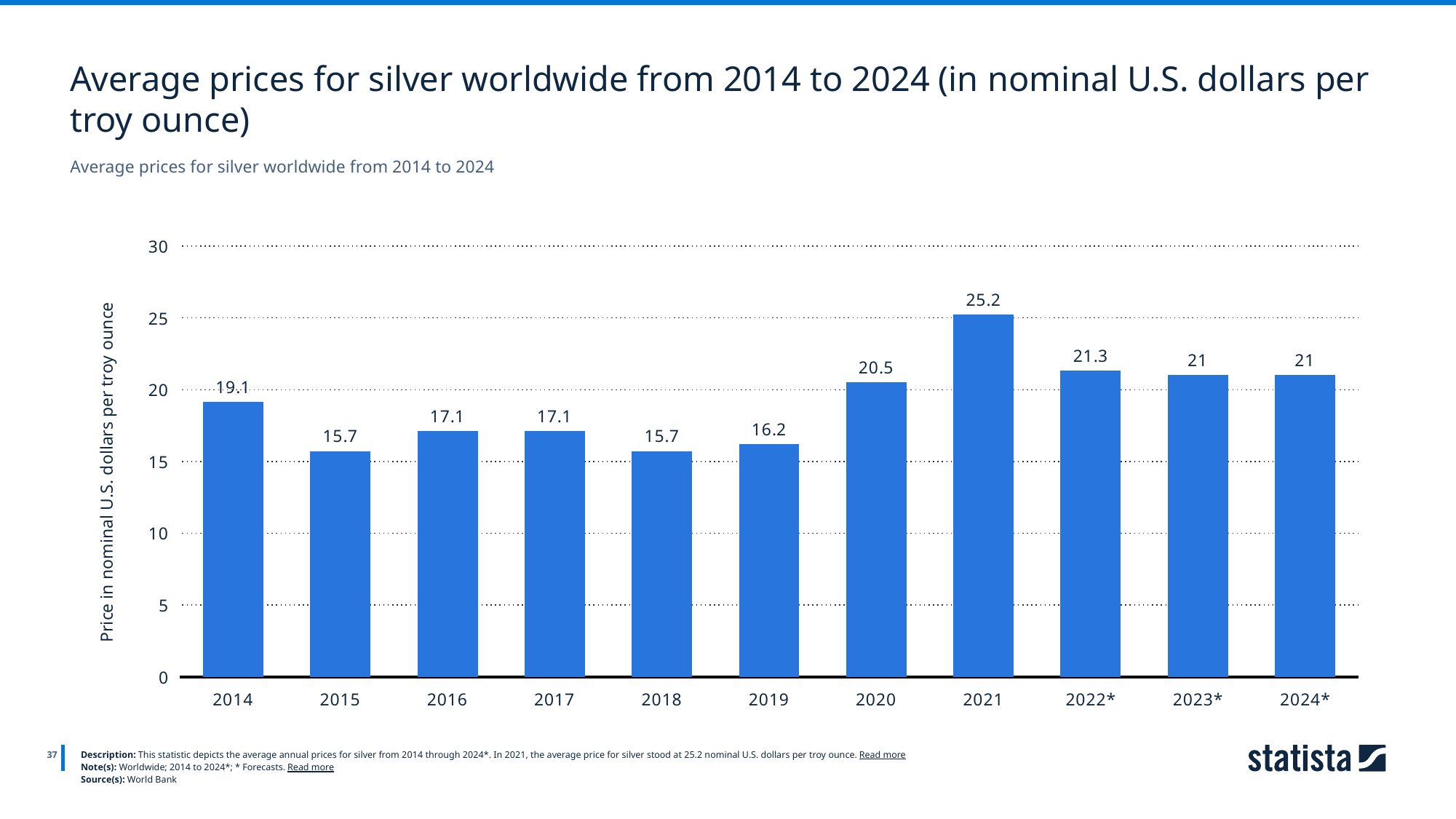
What is the forecast average silver price for 2022*? 21.3 Which year has the highest average silver price? 2021 What was the average price of silver in 2021? 25.2 What is the label of the y axis? Price in nominal U.S. dollars per troy ounce Is the value for 2018 greater or less than 20? less Did the average silver price rise or fall from 2019 to 2021? Rise What is the lowest value shown on the chart? 15.7 What is the difference between the average silver price in 2021 and in 2020? 4.7 What was the average price of silver in 2014? 19.1 How many years are shown on the x axis? 11 Which year had a higher average silver price, 2019 or 2020? 2020 What kind of chart is shown on the slide? Bar chart